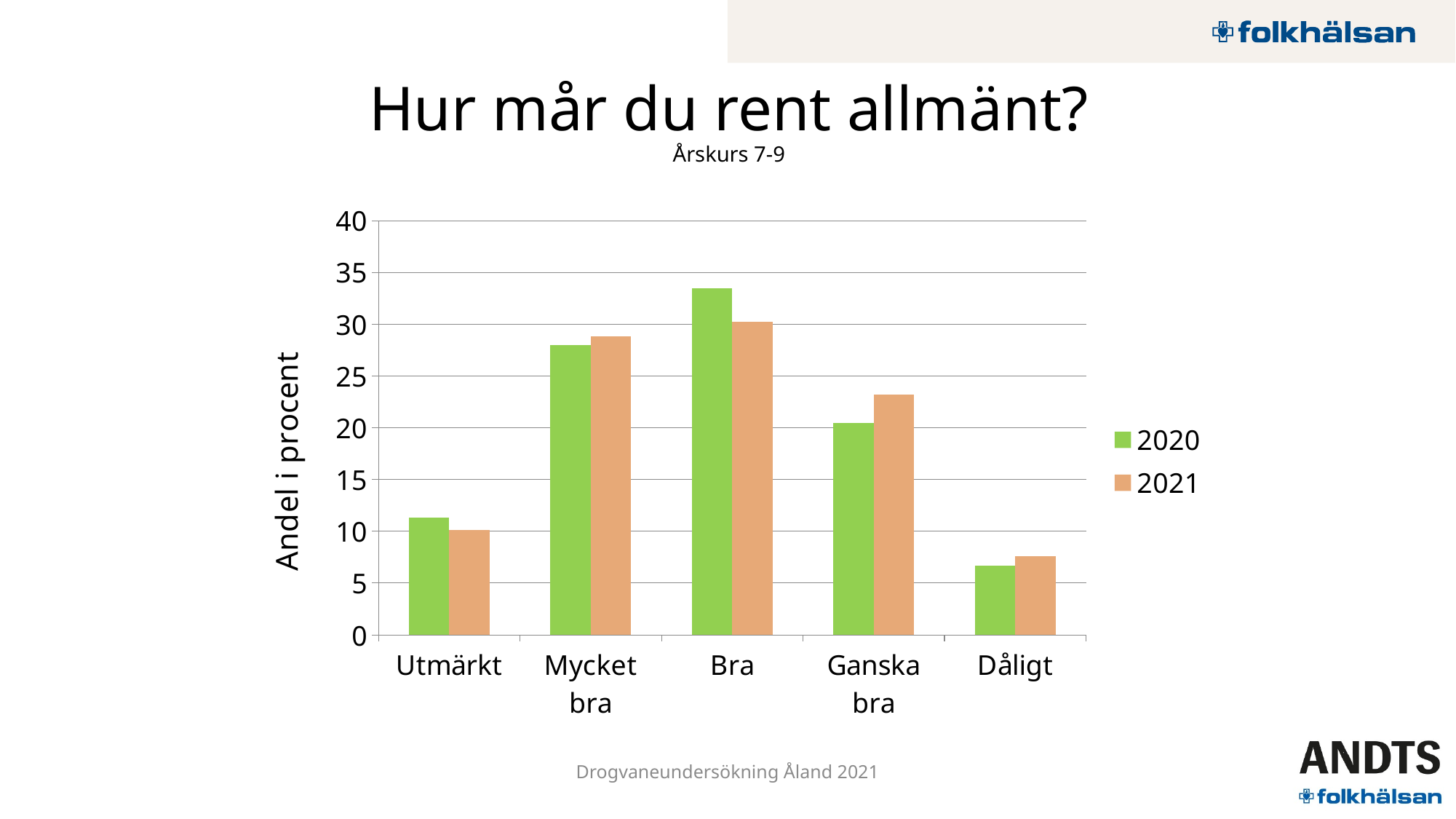
Which category has the lowest value for 2021? Dåligt What is the label of the vertical axis? Andel i procent For Ganska bra, which year has the larger value, 2020 or 2021? 2021 Is the 2020 value for Mycket bra greater or less than 25? greater What kind of chart is shown on the slide? bar chart How many series does the legend list? 2 Is the 2021 value for Dåligt greater or less than 10? less For Bra, which year has the larger value, 2020 or 2021? 2020 How many categories are shown on the x axis? 5 Is the 2021 value for Ganska bra greater or less than 20? greater Which category has the highest value for 2020? Bra